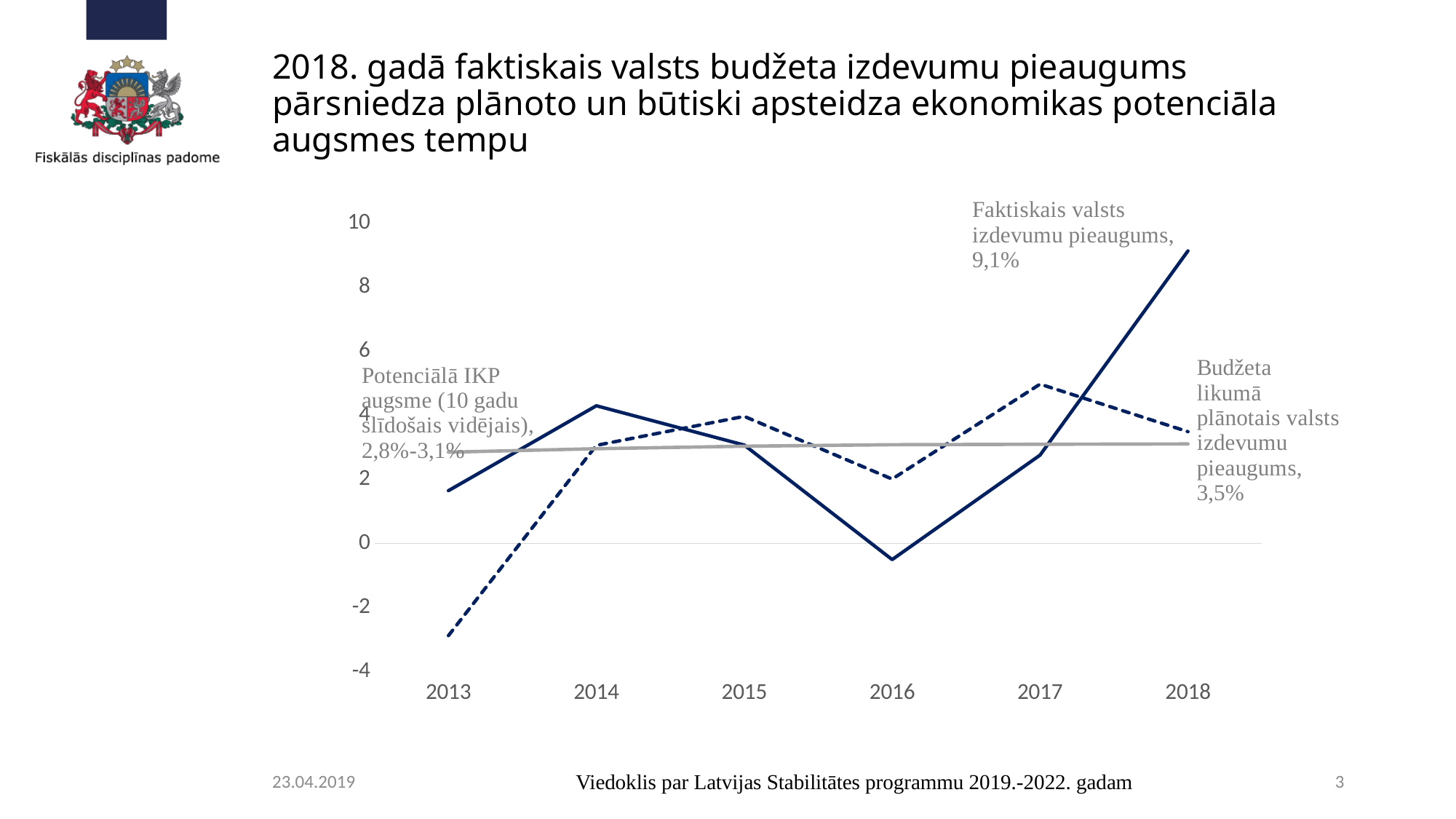
What range is given for the potential GDP growth (Potenciālā IKP augsme, 10-year moving average)? 2,8%-3,1% What kind of chart is shown on the slide? line chart By how many percentage points did the actual state expenditure growth exceed the planned growth in 2018? 5,6 What is the value of the planned state expenditure growth in the budget law (Budžeta likumā plānotais valsts izdevumu pieaugums) in 2018? 3,5% In which year is the planned state expenditure growth (dashed line) lowest? 2013 What is the value of the actual state expenditure growth (Faktiskais valsts izdevumu pieaugums) in 2018? 9,1% Does the actual state expenditure growth (solid line) rise or fall from 2016 to 2018? rise Is the actual state expenditure growth (solid line) in 2016 greater or less than 0? less How many years are shown on the x axis of the chart? 6 In which year is the actual state expenditure growth (solid line) lowest? 2016 In which year is the actual state expenditure growth (solid line) highest? 2018 Is the planned state expenditure growth (dashed line) in 2013 greater or less than -2? less